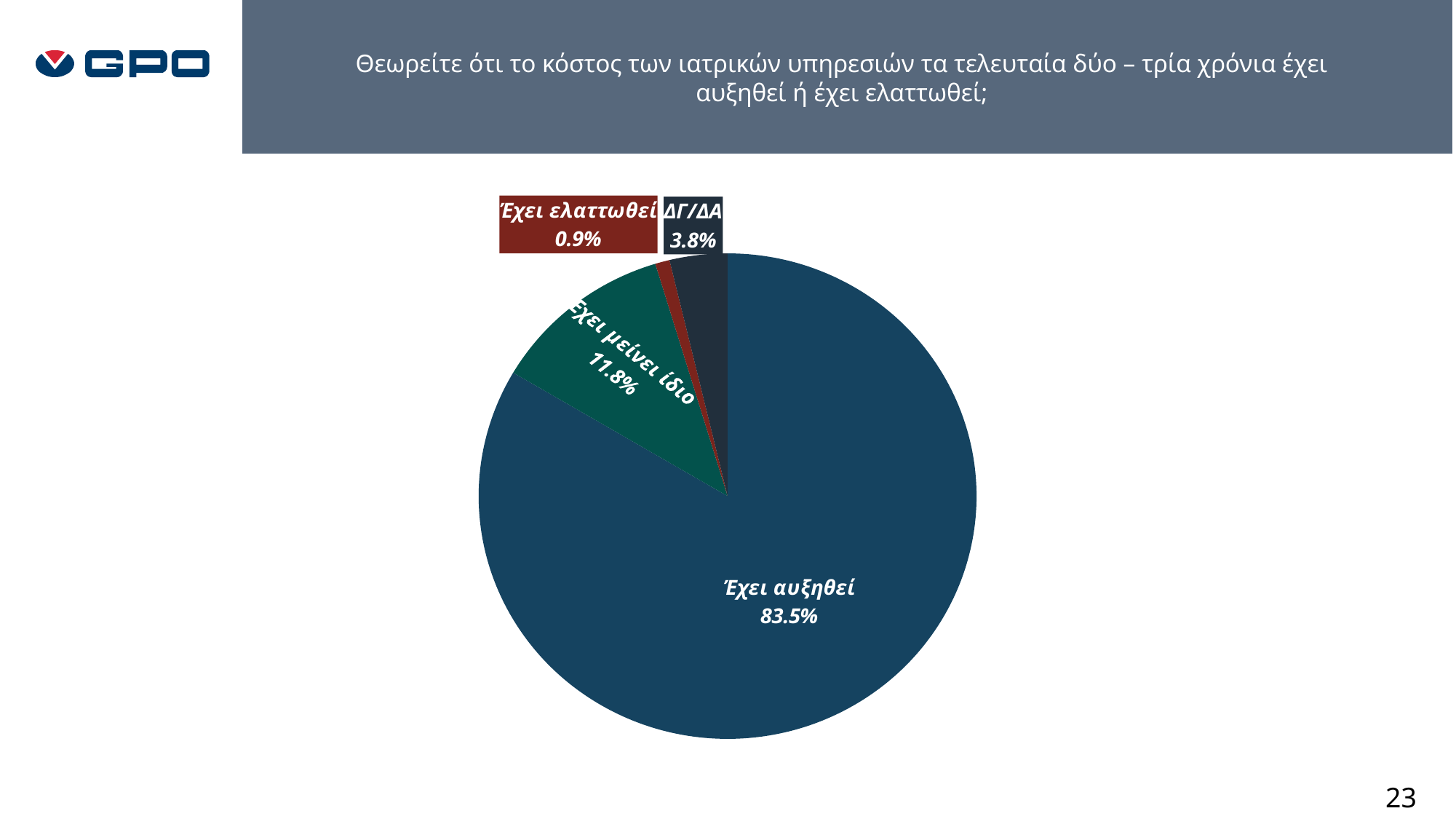
Which is larger: the share for 'ΔΓ/ΔΑ' or the share for 'Έχει μείνει ίδιο'? Έχει μείνει ίδιο What is the difference in percentage points between 'Έχει αυξηθεί' and 'Έχει μείνει ίδιο'? 71.7 What is the difference in percentage points between 'ΔΓ/ΔΑ' and 'Έχει ελαττωθεί'? 2.9 What percentage of respondents answered 'Έχει αυξηθεί'? 83.5% What percentage of respondents answered 'Έχει ελαττωθεί'? 0.9% What colour is the slice for 'Έχει μείνει ίδιο'? Green How many slices does the pie chart have? 4 What percentage of respondents answered 'ΔΓ/ΔΑ'? 3.8% Which response has the largest share of the pie? Έχει αυξηθεί What kind of chart is shown on the slide? Pie chart Which response has the smallest share of the pie? Έχει ελαττωθεί What percentage of respondents answered 'Έχει μείνει ίδιο'? 11.8%